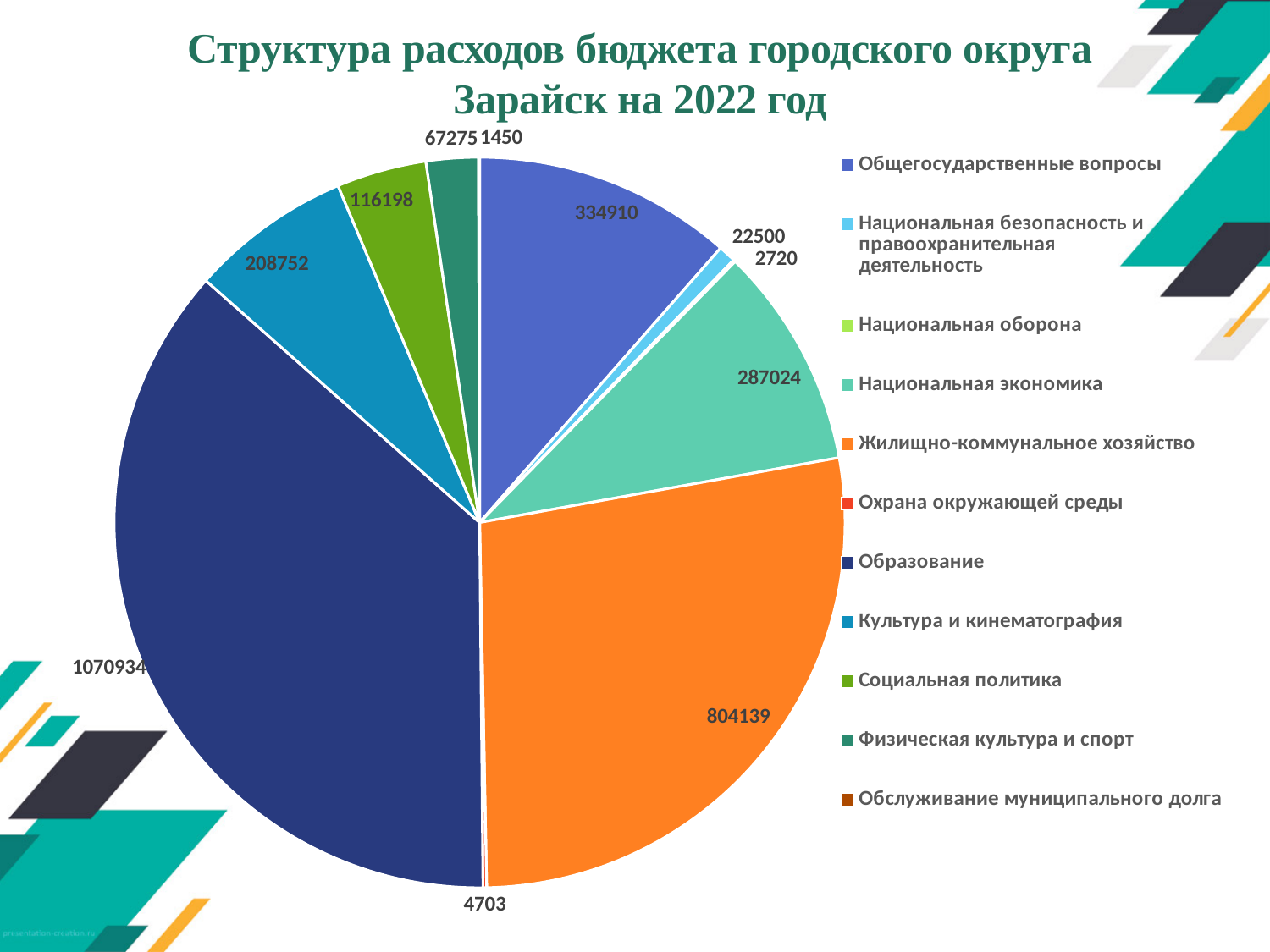
What is the value for Образование in the pie chart? 1070934 Which category has the smallest value in the pie chart? Обслуживание муниципального долга How many categories does the legend list? 11 What type of chart is shown on the slide? Pie chart What is the difference between the values for Образование and Жилищно-коммунальное хозяйство? 266795 What is the difference between the values for Общегосударственные вопросы and Национальная экономика? 47886 Which is larger: Социальная политика or Физическая культура и спорт? Социальная политика What is the value for Национальная оборона? 2720 What is the value for Жилищно-коммунальное хозяйство? 804139 What is the value for Культура и кинематография? 208752 Which category has the largest slice of the pie? Образование What is the title of the chart? Структура расходов бюджета городского округа Зарайск на 2022 год